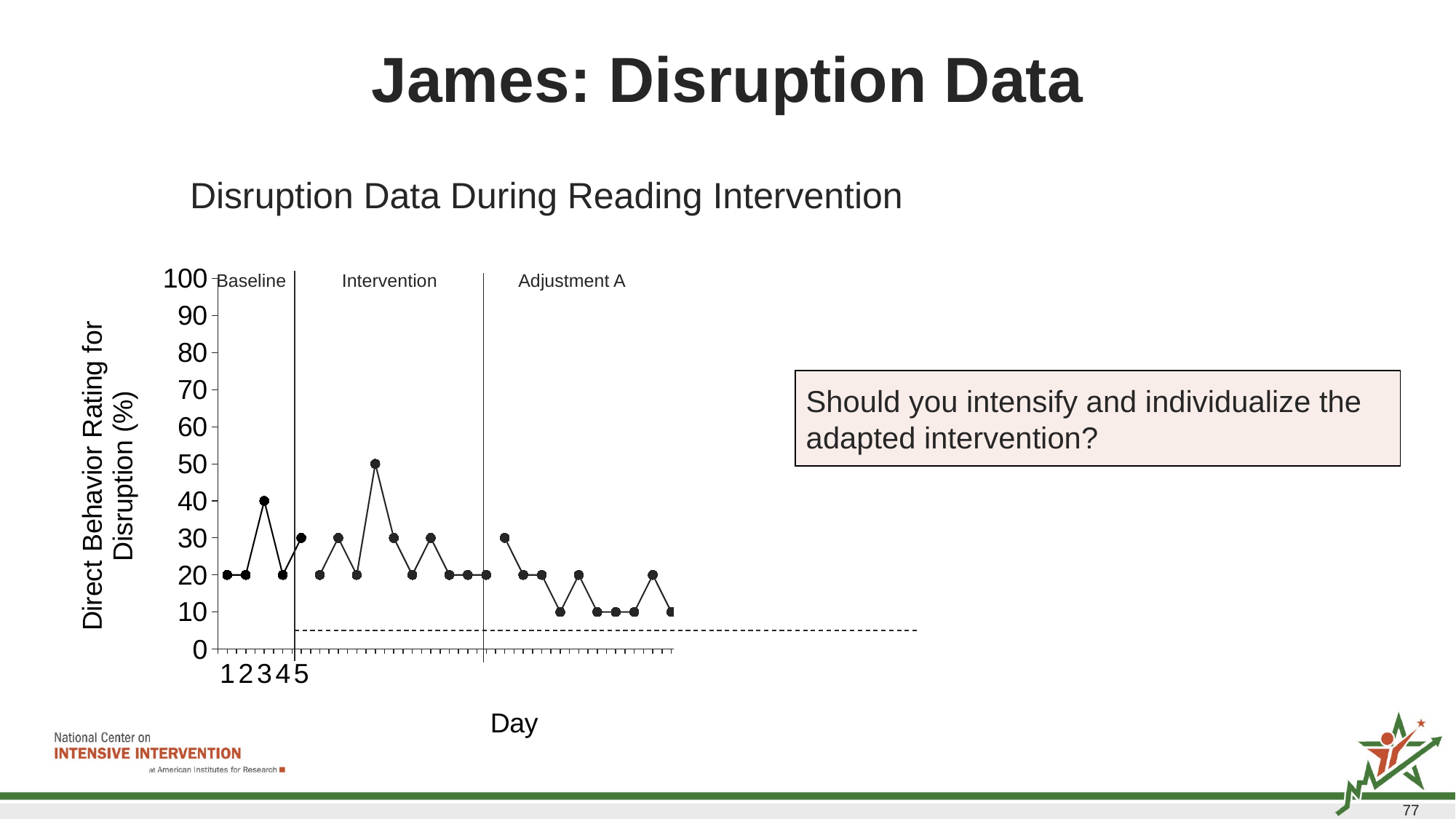
What is the lowest Direct Behavior Rating for Disruption plotted on the chart? 10 How many data points are plotted in the Baseline phase? 5 What is the Direct Behavior Rating for Disruption on Day 3? 40 What is the Direct Behavior Rating for Disruption on Day 5? 30 What are the three phases labelled on the chart? Baseline, Intervention, Adjustment A What kind of chart is shown on the slide? line chart What is the Direct Behavior Rating for Disruption on Day 1? 20 What is the difference between the disruption rating on Day 3 and on Day 1? 20 Which day has the higher disruption rating, Day 3 or Day 5? Day 3 What is the highest Direct Behavior Rating for Disruption plotted on the chart? 50 Is the highest value in the Intervention phase greater or less than 40? greater Do the disruption ratings generally rise or fall across the Adjustment A phase? fall